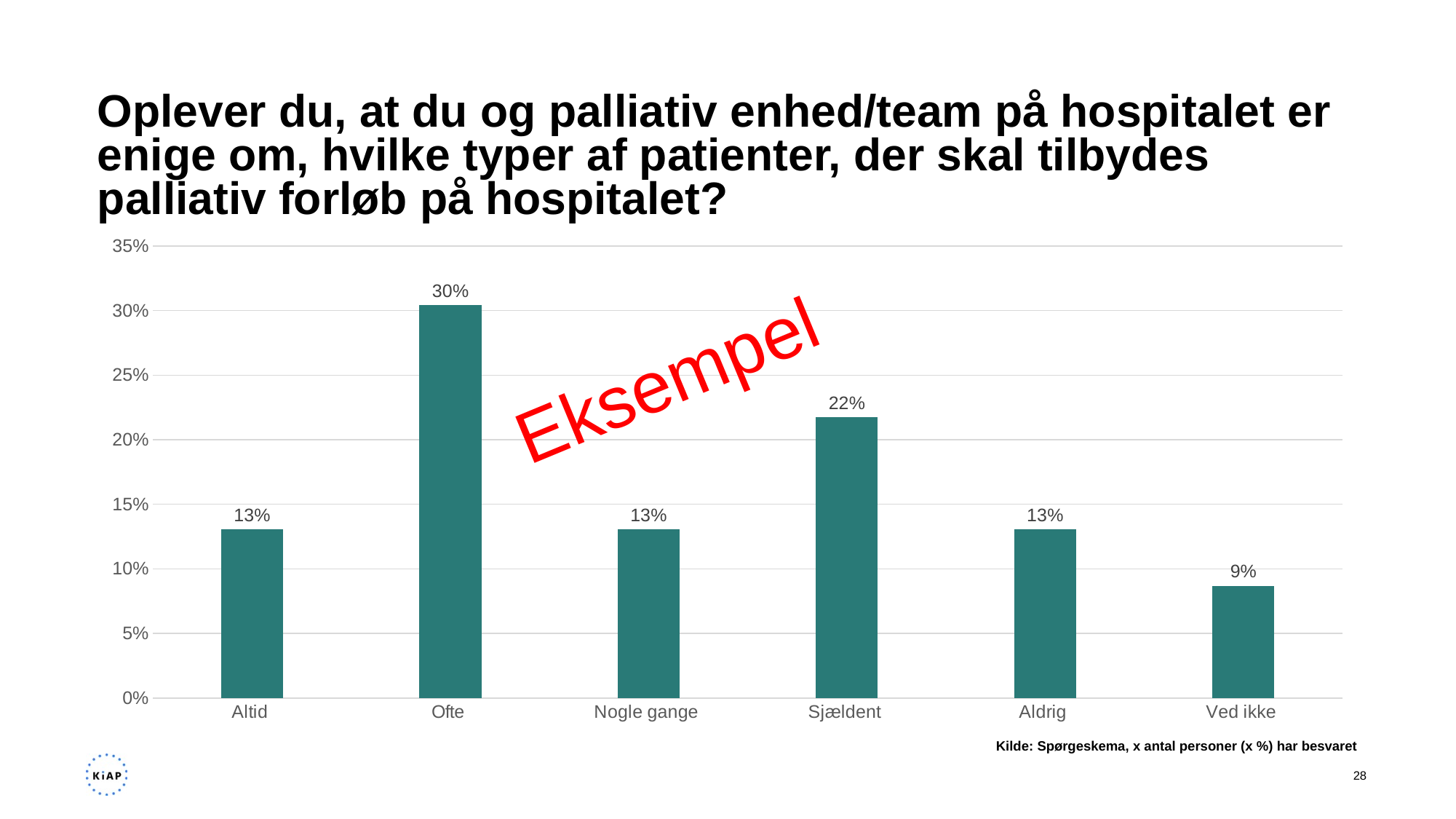
Which category has the lowest value? Ved ikke What is the difference between the values for Ofte and Sjældent? 8% What is the value for Ved ikke? 9% What red word is written diagonally across the chart? Eksempel What is the value for Ofte? 30% How many categories are shown on the x axis? 6 Is the value for Ofte greater or less than 25%? greater What kind of chart is shown on the slide? bar chart Which category has the highest value? Ofte What is the value for Altid? 13% What is the value for Sjældent? 22% Which is larger, the value for Sjældent or the value for Aldrig? Sjældent